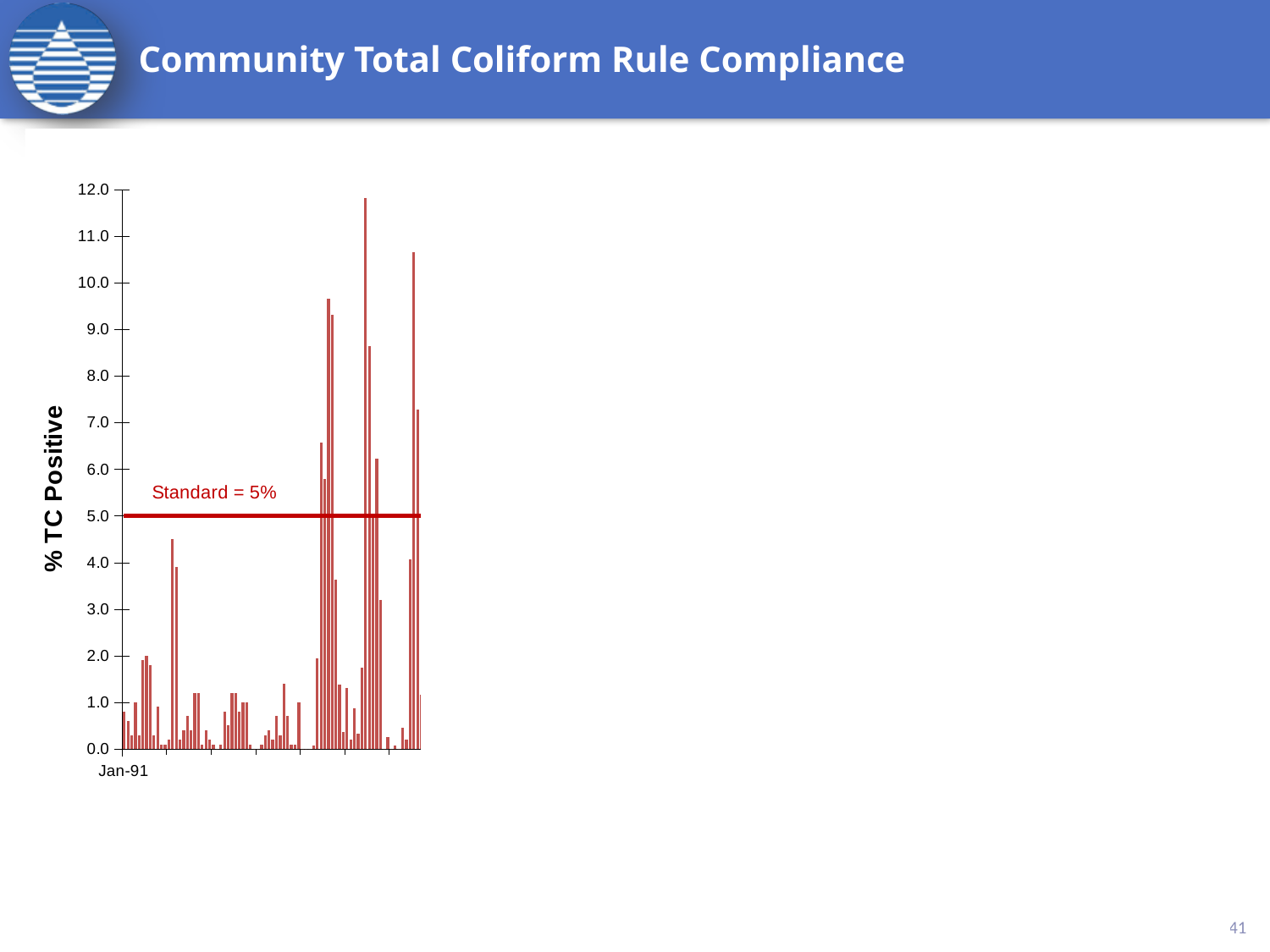
Is the value of the first bar, at Jan-91, greater or less than 1.0? less What kind of chart is shown on the slide? bar chart Is the tallest bar on the chart greater or less than 11.0? greater What value does the red horizontal line on the chart represent, according to its label? Standard = 5% What is the title of the vertical axis of the chart? % TC Positive Is the value of the first bar, at Jan-91, greater or less than 5.0? less What is the highest tick value shown on the vertical axis? 12.0 What is the only date label shown on the horizontal axis? Jan-91